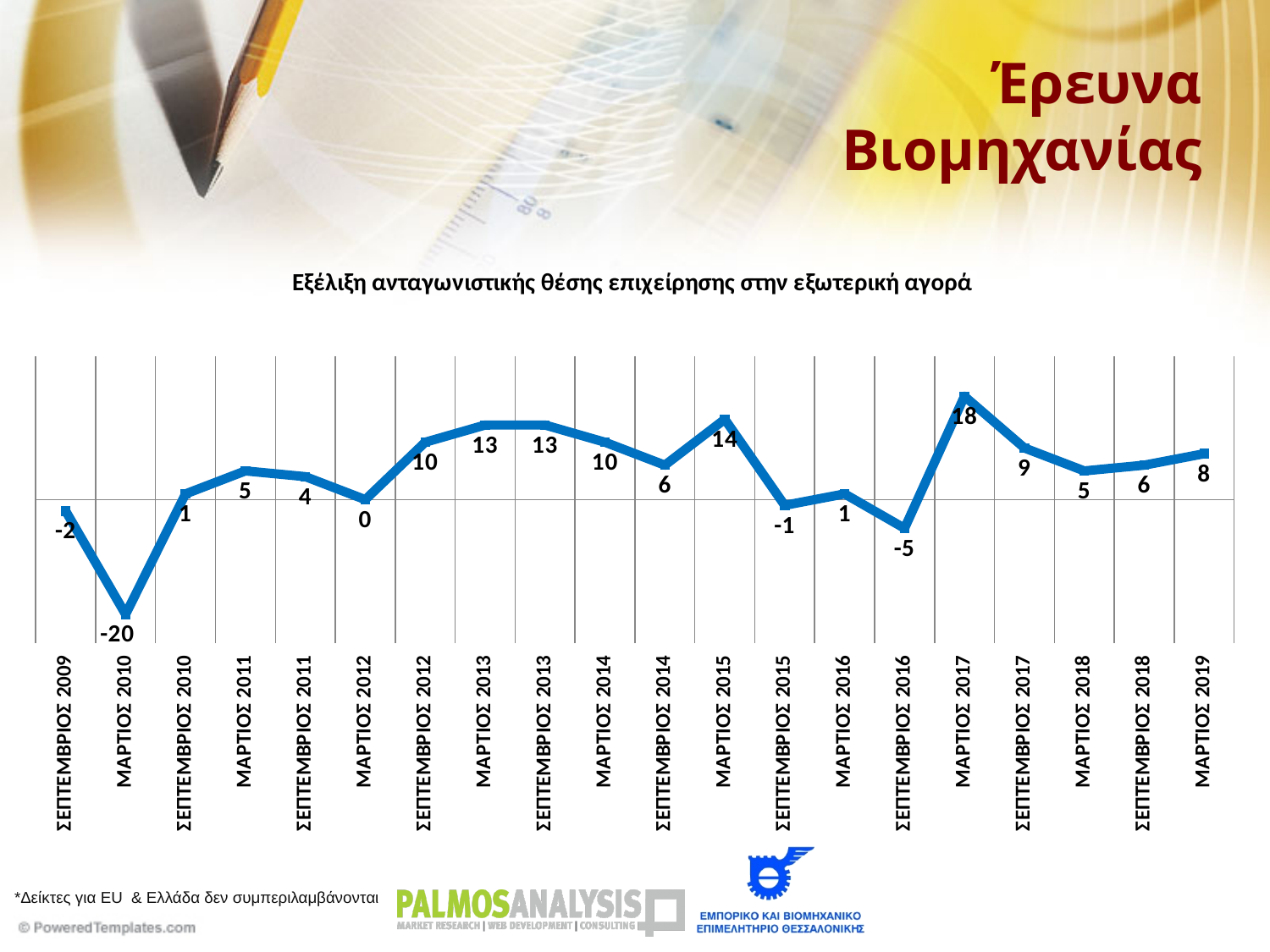
How many data points are plotted on the chart? 20 Does the value rise or fall from ΣΕΠΤΕΜΒΡΙΟΣ 2016 to ΜΑΡΤΙΟΣ 2017? Rise What is the value for ΜΑΡΤΙΟΣ 2010? -20 Which is larger, the value for ΜΑΡΤΙΟΣ 2015 or the value for ΣΕΠΤΕΜΒΡΙΟΣ 2014? ΜΑΡΤΙΟΣ 2015 What is the value for ΣΕΠΤΕΜΒΡΙΟΣ 2016? -5 What is the difference between the values for ΜΑΡΤΙΟΣ 2017 and ΣΕΠΤΕΜΒΡΙΟΣ 2017? 9 Which period has the highest value? ΜΑΡΤΙΟΣ 2017 What is the value for ΜΑΡΤΙΟΣ 2017? 18 What is the title of the chart? Εξέλιξη ανταγωνιστικής θέσης επιχείρησης στην εξωτερική αγορά What is the value for ΜΑΡΤΙΟΣ 2019? 8 What type of chart is shown on the slide? Line chart Which period has the lowest value? ΜΑΡΤΙΟΣ 2010